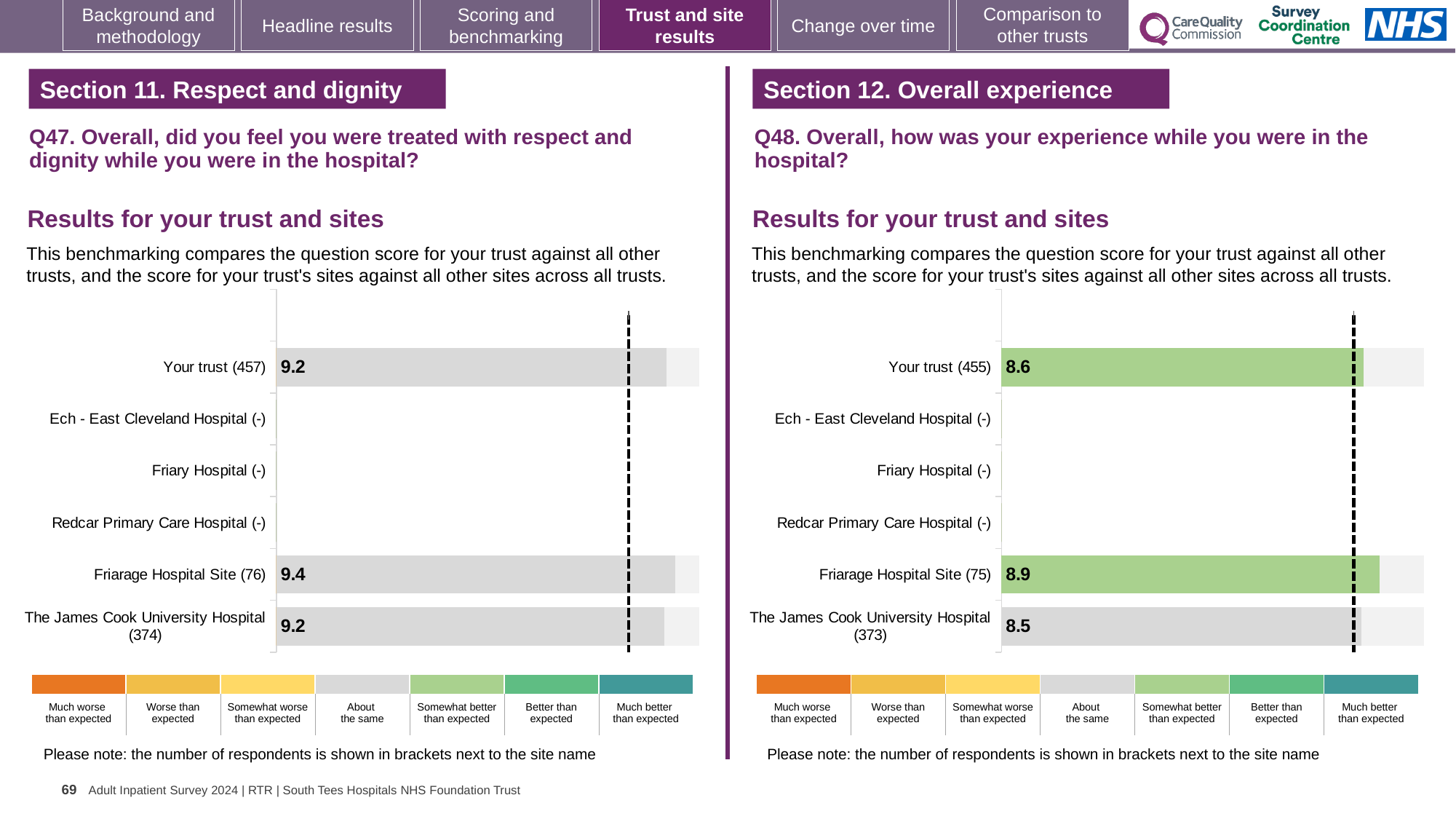
In the Q48 chart on the right, what colour is the bar for Friarage Hospital Site (75)? Green What kind of chart is used in the Q47 chart on the left? Bar chart In the Q47 chart on the left, what is the score for Your trust (457)? 9.2 In the Q48 chart on the right, what is the difference between the Friarage Hospital Site score and The James Cook University Hospital score? 0.4 In the Q47 chart on the left, what is the score for Friarage Hospital Site (76)? 9.4 In the Q48 chart on the right, which site has the highest score? Friarage Hospital Site (75) How many site rows (excluding Your trust) are listed in the Q48 chart on the right? 5 In the Q47 chart on the left, what is the difference between the Friarage Hospital Site score and the Your trust score? 0.2 In the Q48 chart on the right, which is larger: the score for Your trust (455) or the score for Friarage Hospital Site (75)? Friarage Hospital Site (75) In the Q48 chart on the right, which labelled bar has the lowest score? The James Cook University Hospital (373) In the Q48 chart on the right, what is the score for The James Cook University Hospital (373)? 8.5 In the Q48 chart on the right, what is the score for Your trust (455)? 8.6